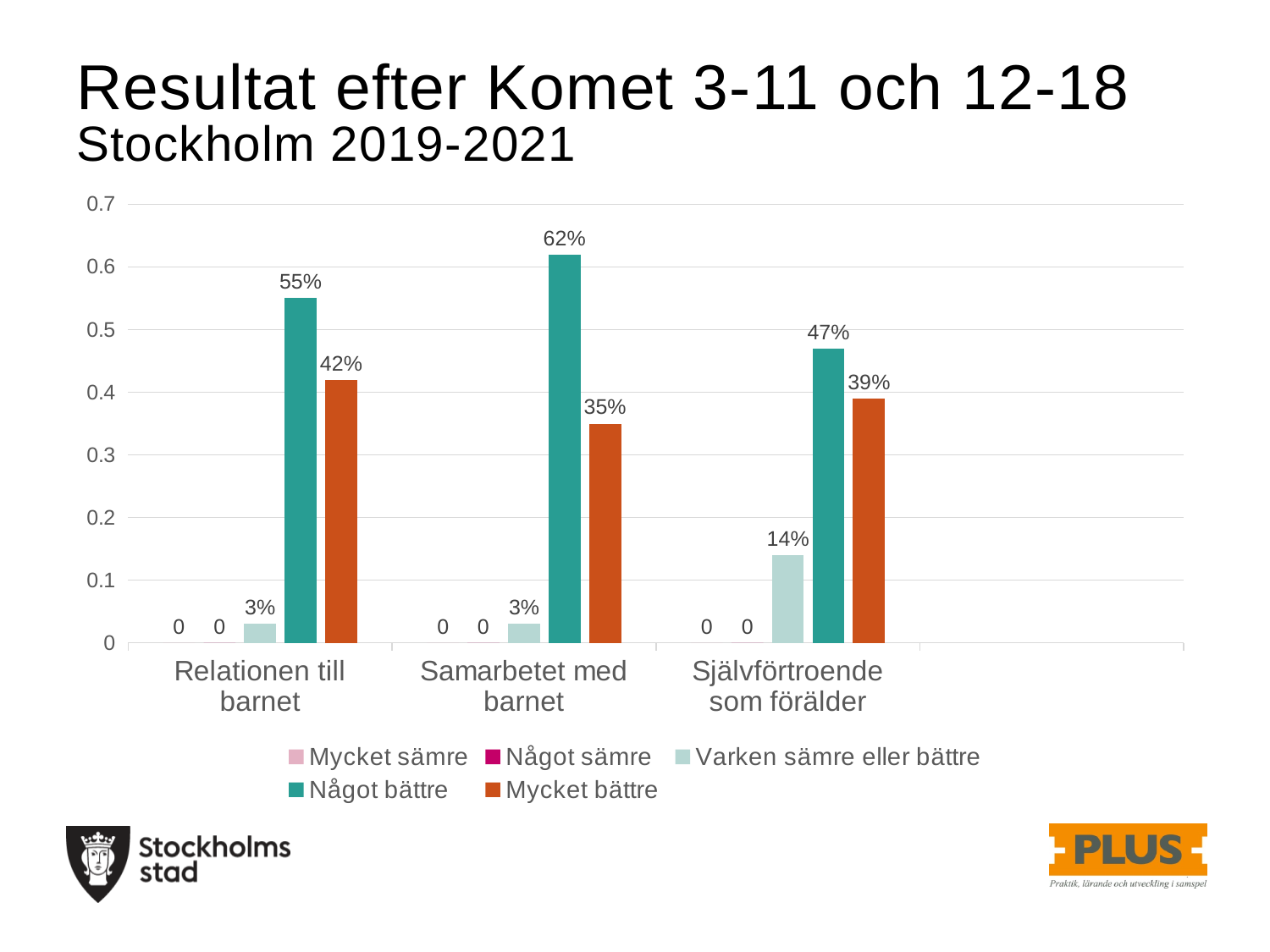
Which category has the lowest value for "Mycket bättre"? Samarbetet med barnet How many categories are shown on the x axis? 3 What is the value for "Varken sämre eller bättre" in the "Självförtroende som förälder" category? 14% What is the value for "Mycket bättre" in the "Relationen till barnet" category? 42% What is the difference between "Något bättre" and "Mycket bättre" in the "Samarbetet med barnet" category? 27% How many series does the legend list? 5 Which category has the highest value for "Något bättre"? Samarbetet med barnet In the "Självförtroende som förälder" category, which is larger: "Något bättre" or "Mycket bättre"? Något bättre What is the value for "Mycket sämre" in the "Relationen till barnet" category? 0 What is the value for "Något bättre" in the "Samarbetet med barnet" category? 62% What is the subtitle of the chart slide? Stockholm 2019-2021 What kind of chart is shown on the slide? Bar chart